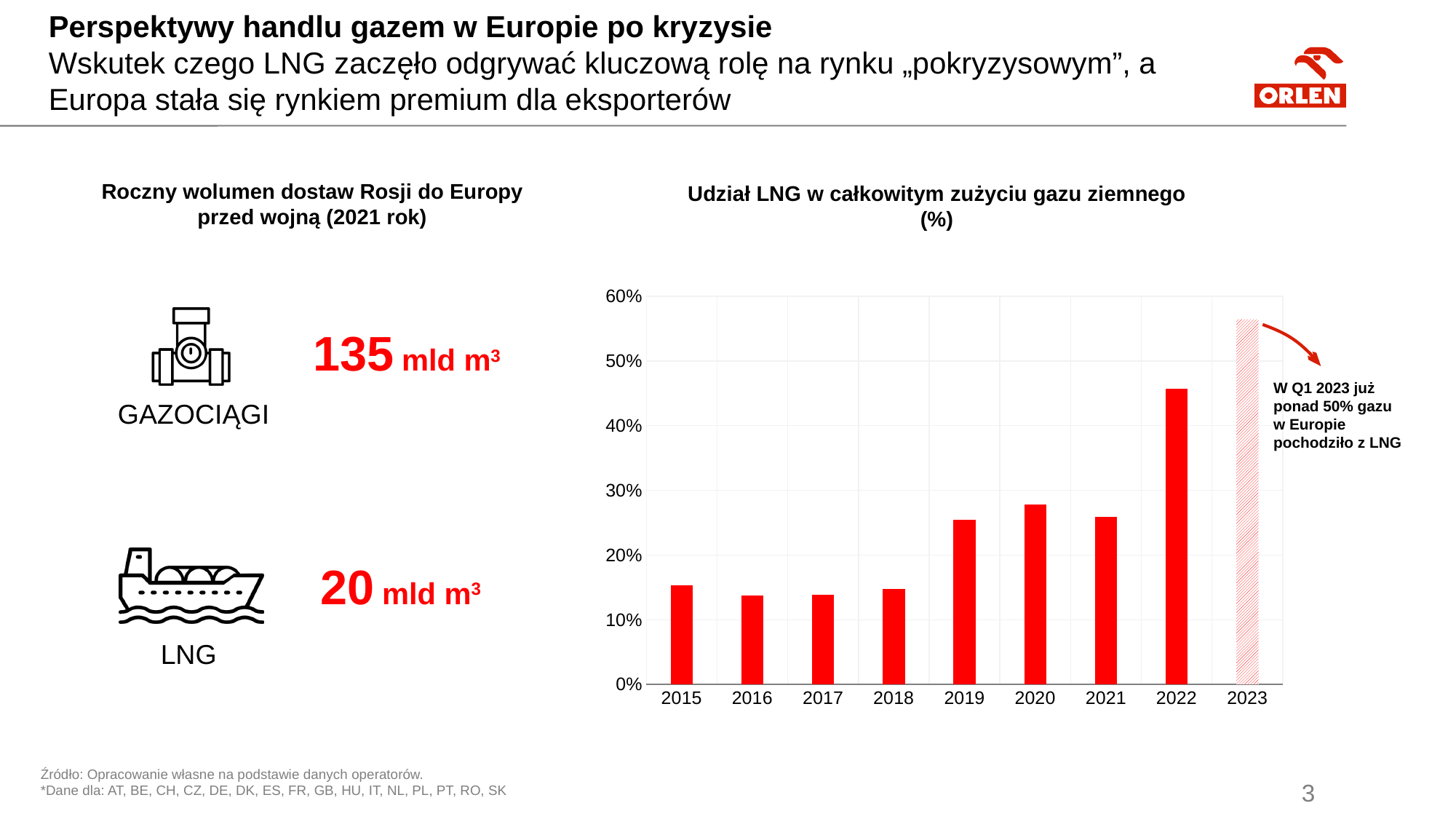
Which year has the highest bar in the LNG share chart? 2023 In the LNG share chart, which year has the larger value, 2021 or 2022? 2022 In the LNG share chart, is the value for 2020 greater or less than 30%? less How many years are shown on the x axis of the LNG share chart? 9 In the LNG share chart, is the value for 2022 greater or less than 50%? less In the LNG share chart, is the value for 2015 greater or less than 20%? less Which year's bar in the LNG share chart is drawn with a hatched pattern instead of solid red? 2023 In the LNG share chart, do the values generally rise or fall from 2015 to 2023? rise What kind of chart is shown under the title "Udział LNG w całkowitym zużyciu gazu ziemnego (%)"? bar chart In the LNG share chart, which year has the larger value, 2018 or 2019? 2019